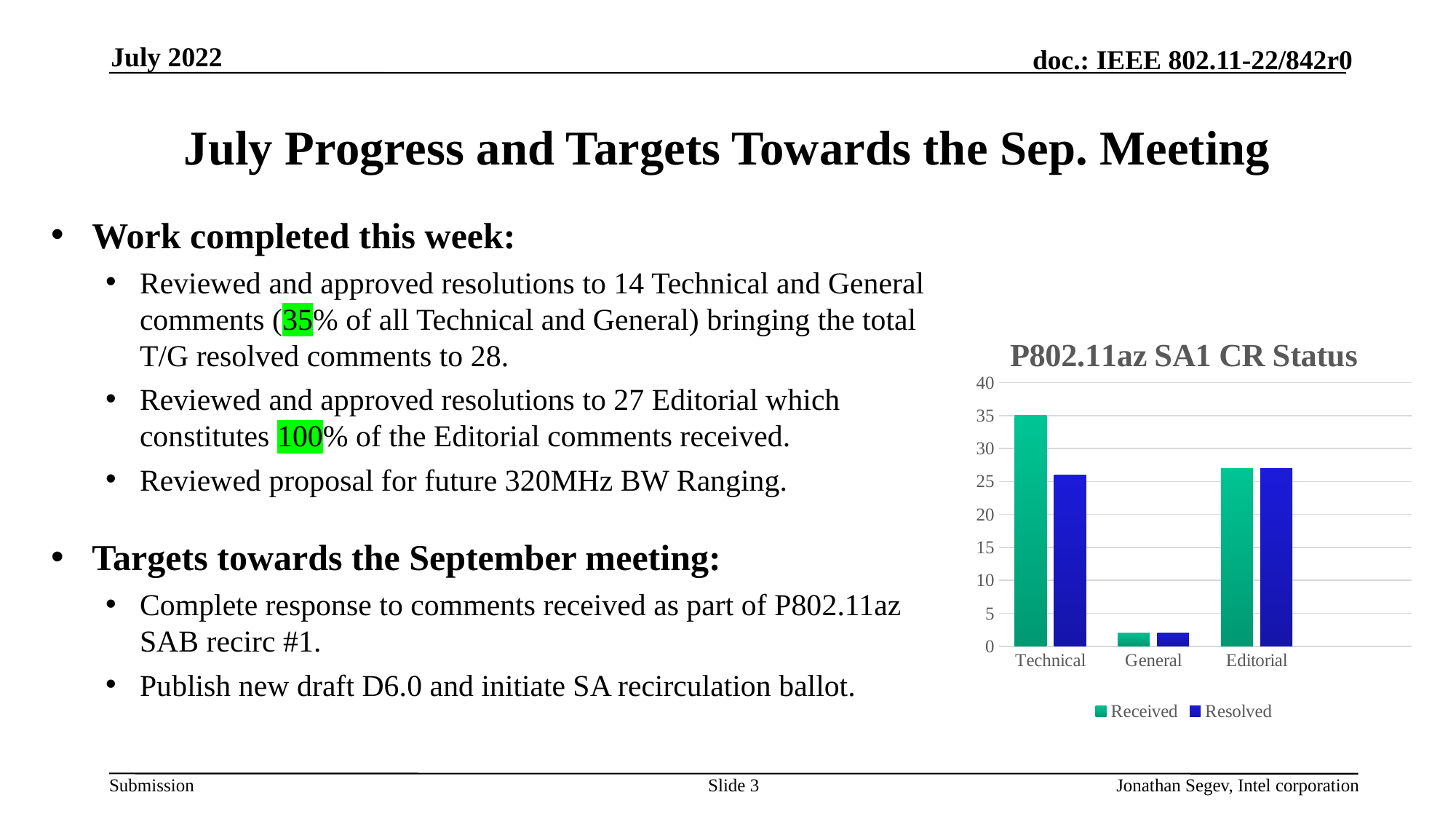
What is the title of the chart? P802.11az SA1 CR Status For Technical, which is larger: the Received value or the Resolved value? Received Which series are listed in the chart's legend? Received, Resolved What is the Received value for Technical? 35 Which category has the highest Received value? Technical How many categories are shown on the x axis of the chart? 3 How many series does the chart's legend list? 2 Which category has the lowest Received value? General Is the Received value for General greater or less than 5? less What kind of chart is shown on the slide? bar chart Is the Resolved value for Technical greater or less than 30? less Is the Received value for Editorial greater or less than 25? greater